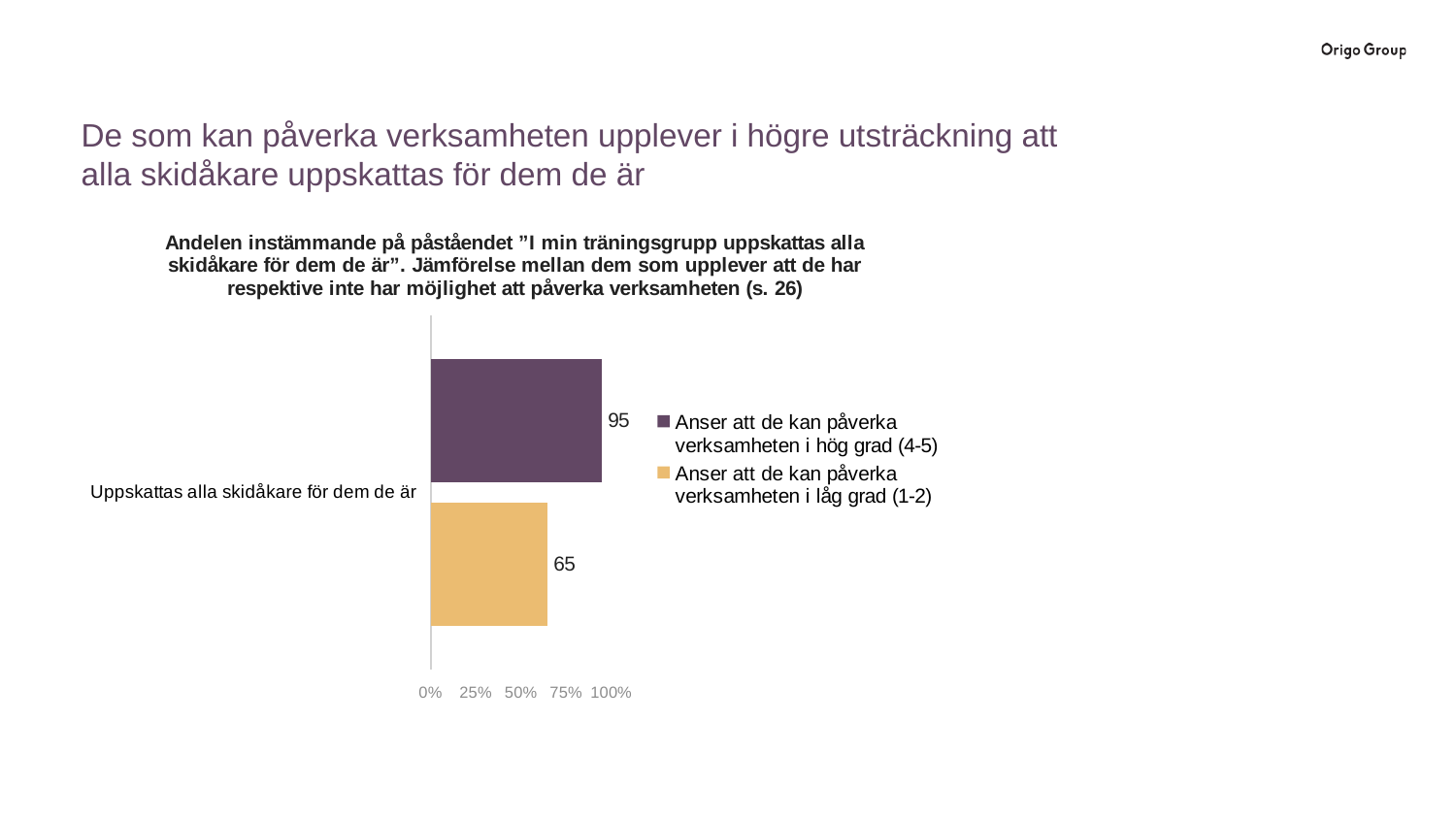
How many categories are shown on the chart? 1 Which series is shown in the purple colour? Anser att de kan påverka verksamheten i hög grad (4-5) What is the value for the series "Anser att de kan påverka verksamheten i hög grad (4-5)" for the category "Uppskattas alla skidåkare för dem de är"? 95 What is the category label shown on the chart? Uppskattas alla skidåkare för dem de är What is the difference between the values for the "hög grad (4-5)" series and the "låg grad (1-2)" series? 30 What is the value for the series "Anser att de kan påverka verksamheten i låg grad (1-2)" for the category "Uppskattas alla skidåkare för dem de är"? 65 Which series has the higher value: "Anser att de kan påverka verksamheten i hög grad (4-5)" or "Anser att de kan påverka verksamheten i låg grad (1-2)"? Anser att de kan påverka verksamheten i hög grad (4-5) How many series does the legend list? 2 Is the value for the "Anser att de kan påverka verksamheten i låg grad (1-2)" series greater or less than 75%? less Is the value for the "Anser att de kan påverka verksamheten i hög grad (4-5)" series greater or less than 75%? greater What kind of chart is shown on the slide? Bar chart What is the highest value shown on the x axis? 100%